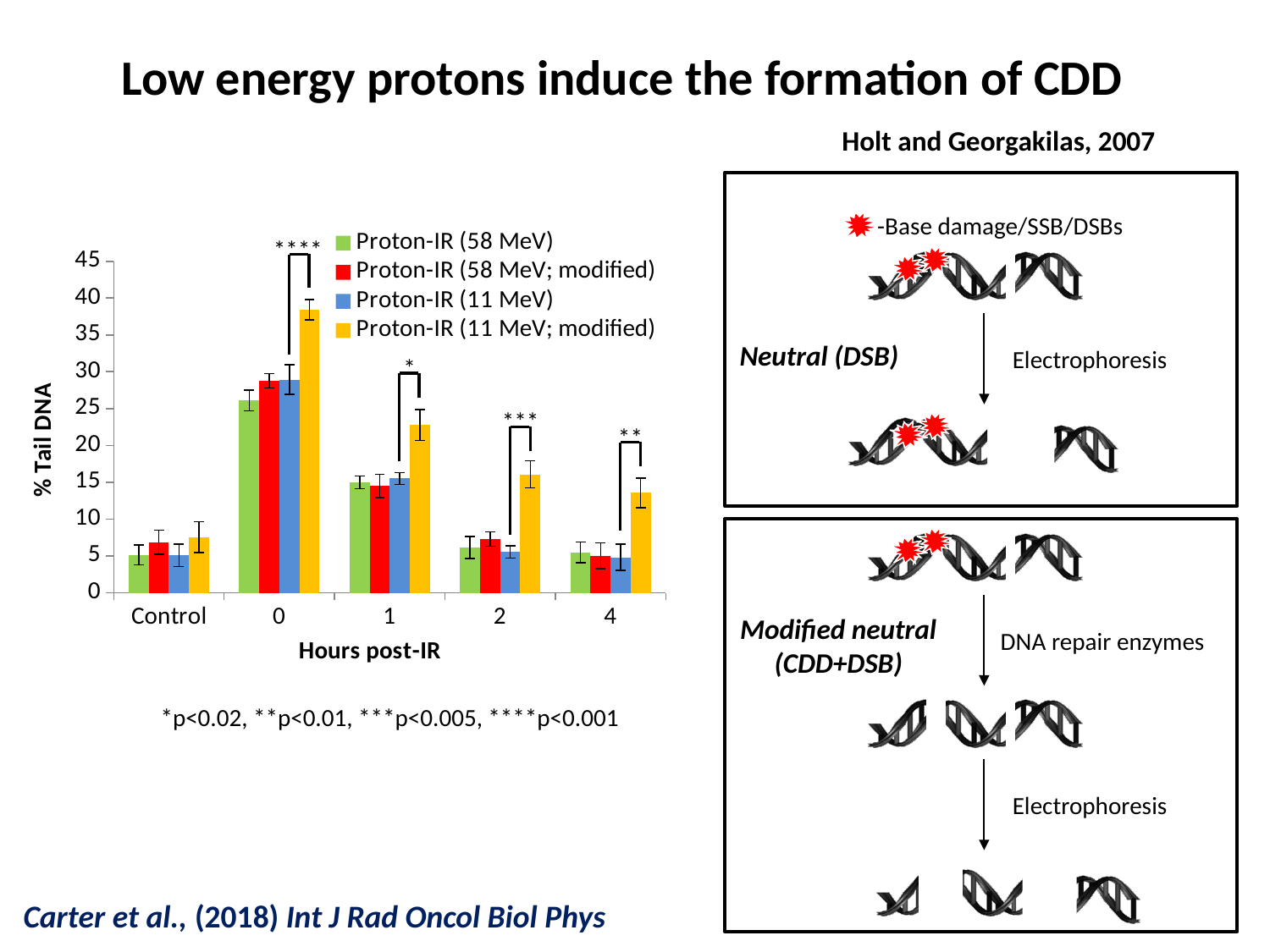
What is the label of the x axis of the chart? Hours post-IR Is the value for Proton-IR (58 MeV) at 1 hour post-IR greater or less than 20? less How many categories are shown on the x axis of the chart? 5 Is the value for Proton-IR (11 MeV; modified) at 0 hours post-IR greater or less than 35? greater Is the value for Proton-IR (11 MeV; modified) at 2 hours post-IR greater or less than 10? greater What kind of chart is shown on the slide? bar chart Which is larger at 4 hours post-IR: Proton-IR (11 MeV; modified) or Proton-IR (58 MeV)? Proton-IR (11 MeV; modified) Do the values for Proton-IR (11 MeV; modified) rise or fall from 0 hours to 4 hours post-IR? fall How many series does the chart's legend list? 4 Which series has the highest bar at 0 hours post-IR? Proton-IR (11 MeV; modified) What is the label of the y axis of the chart? % Tail DNA Which category on the x axis has the lowest bars overall? Control